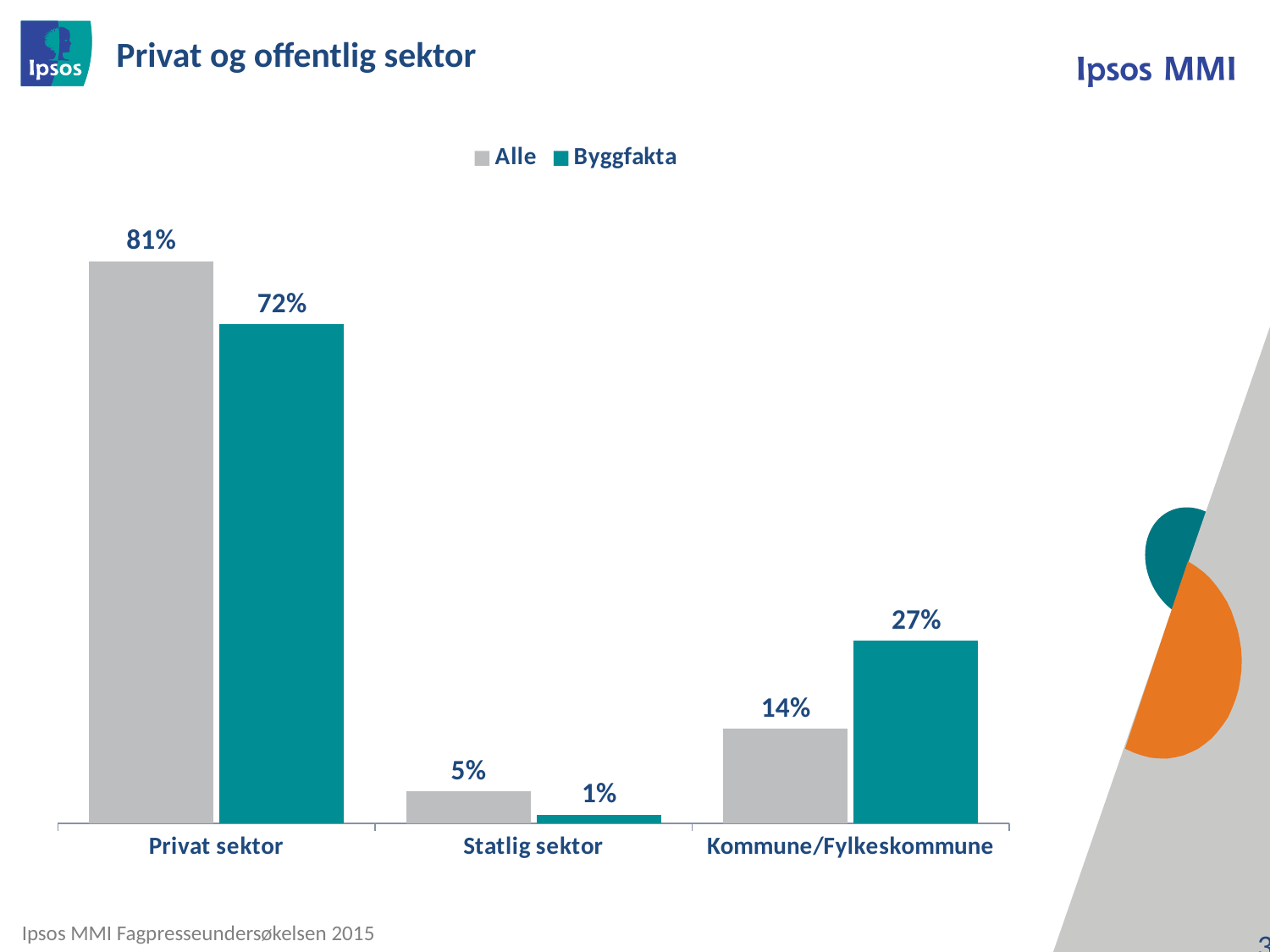
What is the value for Byggfakta in Statlig sektor? 1% What is the difference between Alle and Byggfakta in Privat sektor? 9% Which category has the lowest value for Alle? Statlig sektor What is the difference between Byggfakta and Alle in Kommune/Fylkeskommune? 13% Which is larger in Statlig sektor, Alle or Byggfakta? Alle What is the value for Alle in Privat sektor? 81% How many categories are shown on the x axis? 3 Which category has the highest value for Byggfakta? Privat sektor What is the value for Alle in Kommune/Fylkeskommune? 14% How many series does the legend list? 2 What is the value for Byggfakta in Kommune/Fylkeskommune? 27% What kind of chart is shown on the slide? Bar chart